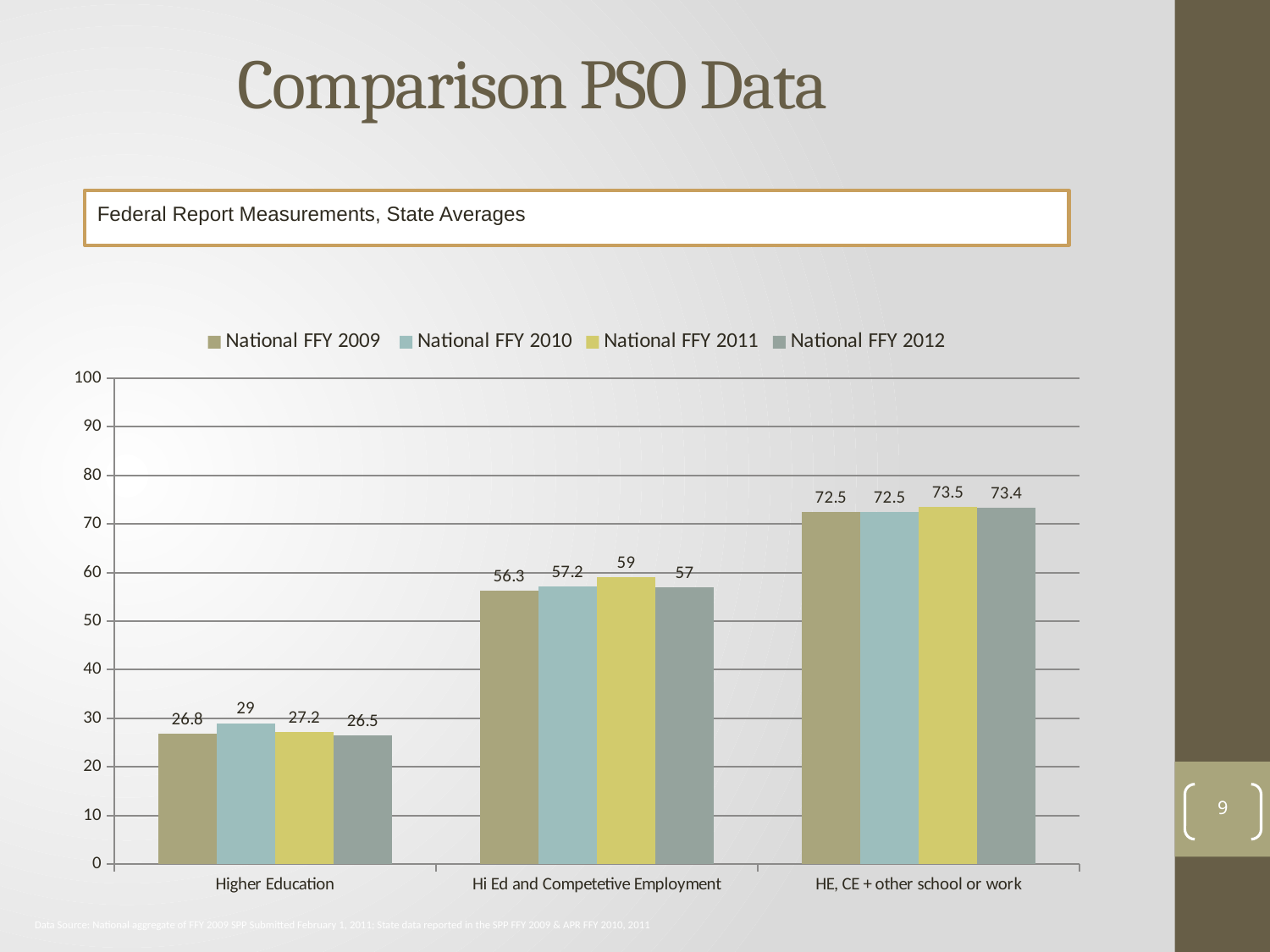
What is the National FFY 2011 value for Hi Ed and Competetive Employment? 59 What is the National FFY 2009 value for Higher Education? 26.8 What is the difference between the National FFY 2011 and National FFY 2009 values for Hi Ed and Competetive Employment? 2.7 Which category has the lowest values across all series? Higher Education What kind of chart is shown on the slide? bar chart What is the maximum value shown on the y axis? 100 Which series has the highest value for Higher Education? National FFY 2010 Which is larger for Higher Education: the National FFY 2011 value or the National FFY 2012 value? National FFY 2011 How many categories are shown on the x axis? 3 How many series does the legend list? 4 What is the National FFY 2012 value for HE, CE + other school or work? 73.4 Is the National FFY 2012 value for Hi Ed and Competetive Employment greater or less than 60? less